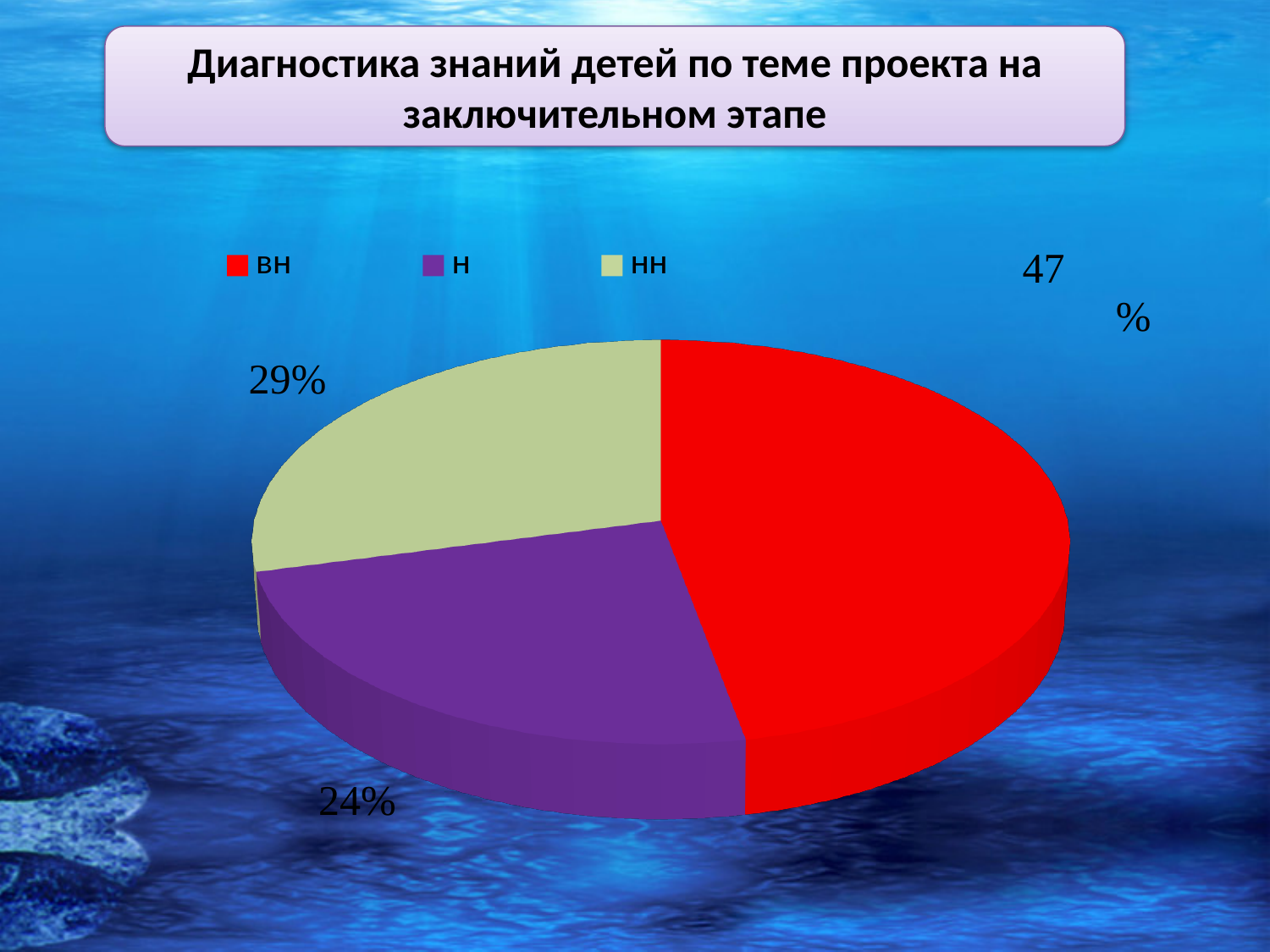
What is the difference in percentage points between the ВН and Н slices? 23 What kind of chart is shown on the slide? pie chart What percentage is shown for the ВН slice? 47% Which is larger, the НН slice or the Н slice? НН How many entries does the legend list? 3 What percentage is shown for the Н slice? 24% What colour is the ВН slice? red What percentage is shown for the НН slice? 29% What is the title of the slide containing the chart? Диагностика знаний детей по теме проекта на заключительном этапе Which category has the largest share of the pie? ВН Which category has the smallest share of the pie? Н How many slices does the pie chart have? 3